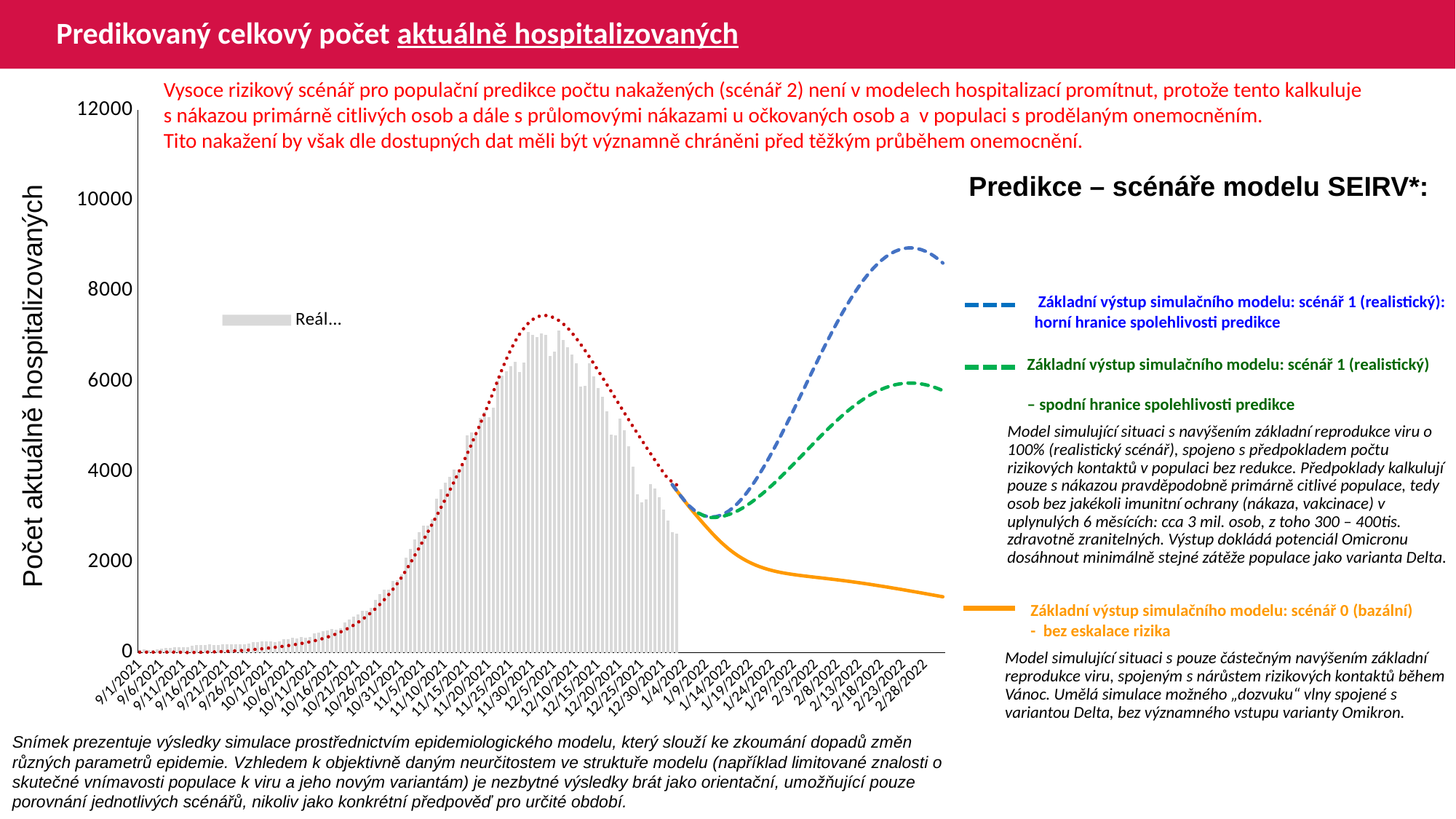
Does the orange line (scenario 0) rise or fall between 1/9/2022 and 2/28/2022? fall What is the label of the vertical axis of the chart? Počet aktuálně hospitalizovaných What kind of chart is used to show the real hospitalized values (Reál...)? bar chart Which prediction line is highest at 2/28/2022: the blue dashed, the green dashed, or the orange line? blue dashed Is the peak of the green dashed line (scenario 1, lower bound) greater or less than 5000? greater Is the peak of the blue dashed line (scenario 1, upper bound) greater or less than 8000? greater Is the highest real hospitalized bar greater or less than 6000? greater What is the title of the chart on the slide? Predikovaný celkový počet aktuálně hospitalizovaných Which prediction line is lowest at 2/28/2022: the blue dashed, the green dashed, or the orange line? orange Does the blue dashed line rise or fall between 1/14/2022 and 2/18/2022? rise What is the highest value shown on the vertical axis of the chart? 12000